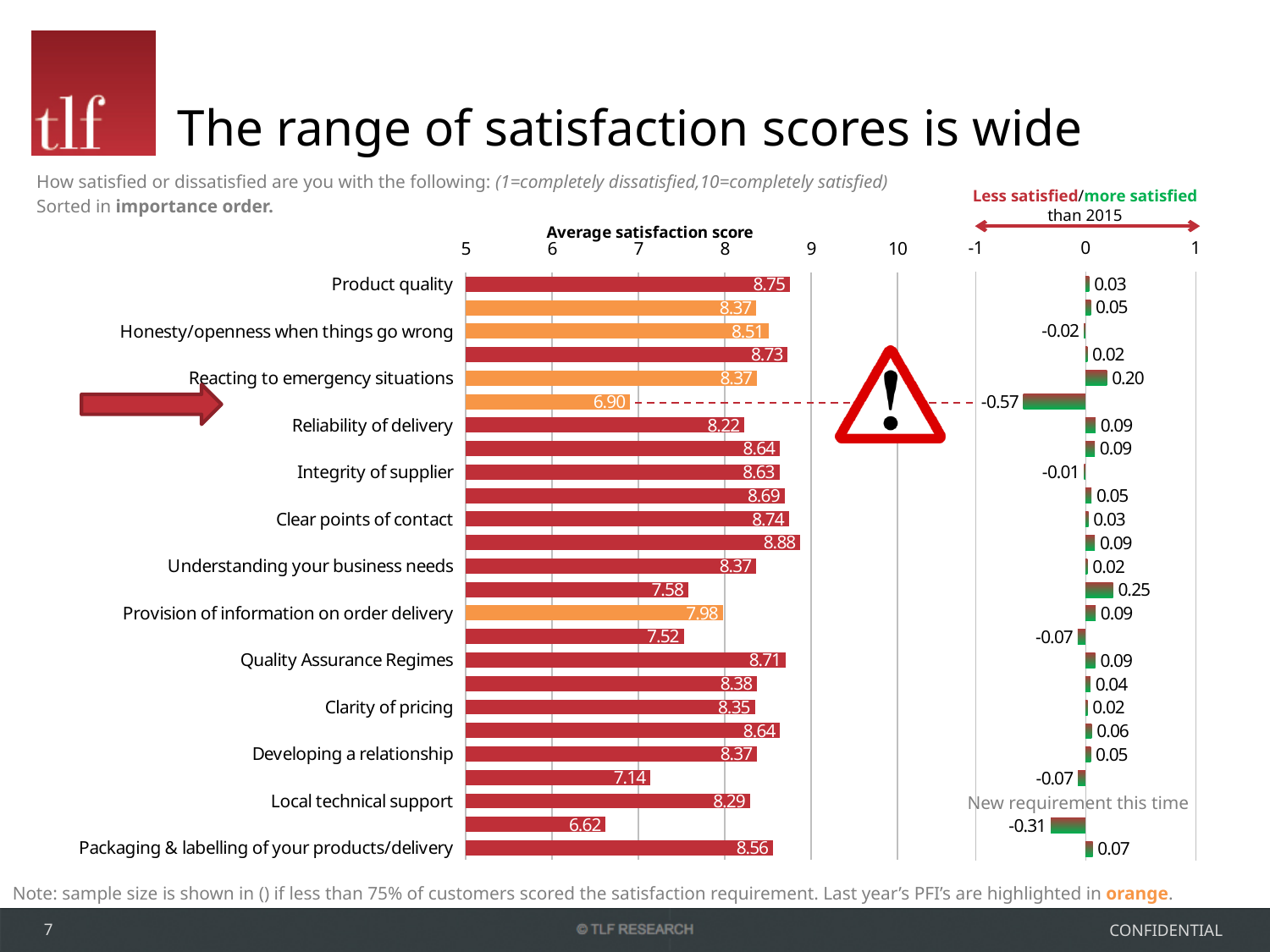
What kind of chart is used to show the average satisfaction scores? bar chart What is the average satisfaction score for Packaging & labelling of your products/delivery? 8.56 What is the change versus 2015 shown for Honesty/openness when things go wrong? -0.02 Is the average satisfaction score for Provision of information on order delivery greater or less than 8? less What is the average satisfaction score for Reliability of delivery? 8.22 What is shown in place of a change value for Local technical support? New requirement this time Which has the higher average satisfaction score, Quality Assurance Regimes or Clarity of pricing? Quality Assurance Regimes What is the average satisfaction score for Product quality? 8.75 What is the average satisfaction score for Provision of information on order delivery? 7.98 What is the difference between the average satisfaction scores for Product quality and Reliability of delivery? 0.53 What is the change versus 2015 shown for Reacting to emergency situations? 0.20 How many bars are plotted in the average satisfaction score chart? 25